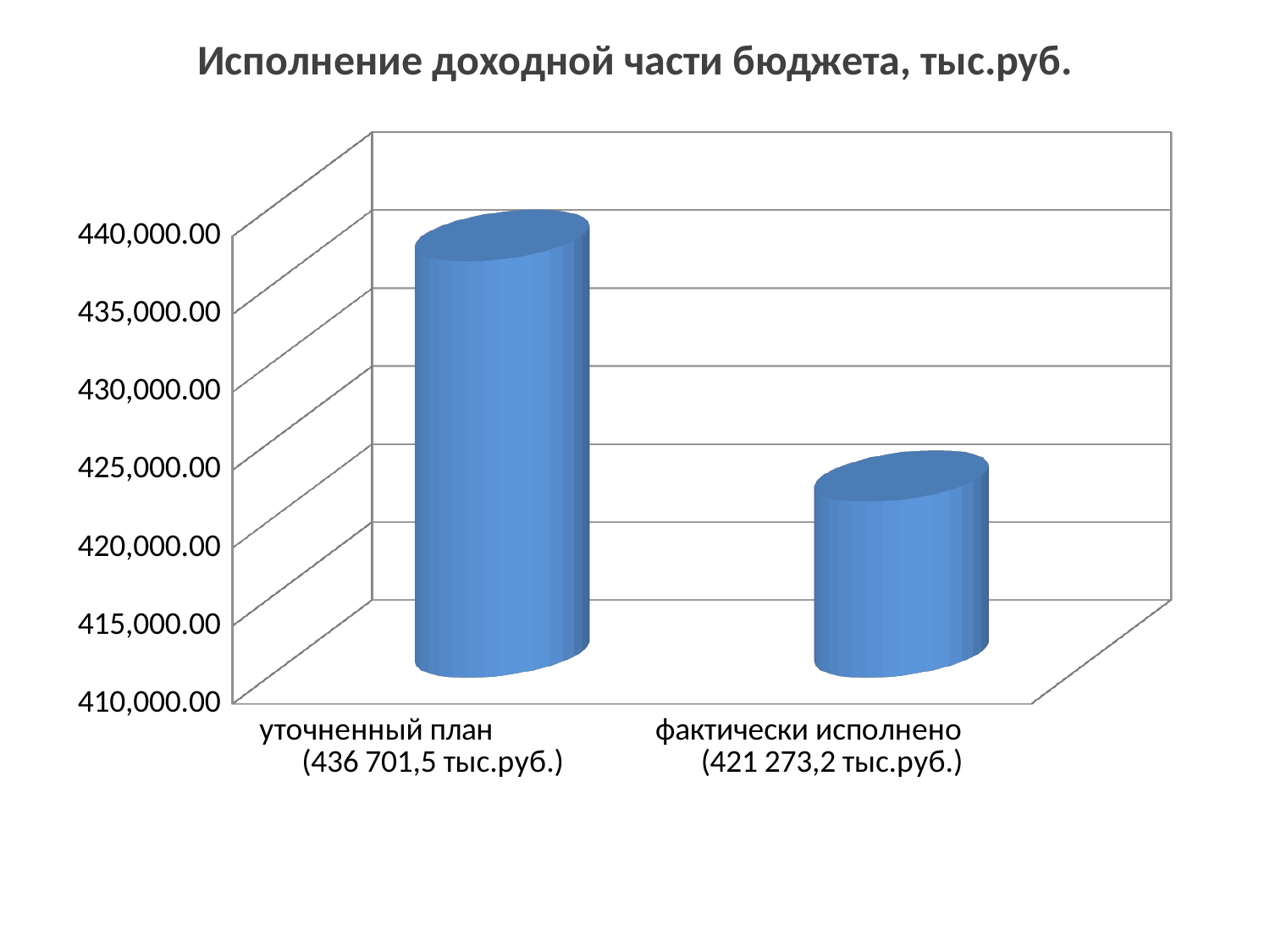
What is the title of the chart? Исполнение доходной части бюджета, тыс.руб. Do the values rise or fall from left to right along the x axis? fall Which is larger, "уточненный план" or "фактически исполнено"? уточненный план What is the difference between "уточненный план" and "фактически исполнено"? 15 428,3 тыс.руб. What value is given for "уточненный план"? 436 701,5 тыс.руб. How many categories (bars) does the chart show? 2 Is the value for "фактически исполнено" greater or less than 425,000.00? less Which category has the highest value? уточненный план Which category has the lowest value? фактически исполнено What kind of chart is shown on the slide? bar chart Is the value for "уточненный план" greater or less than 435,000.00? greater What value is given for "фактически исполнено"? 421 273,2 тыс.руб.